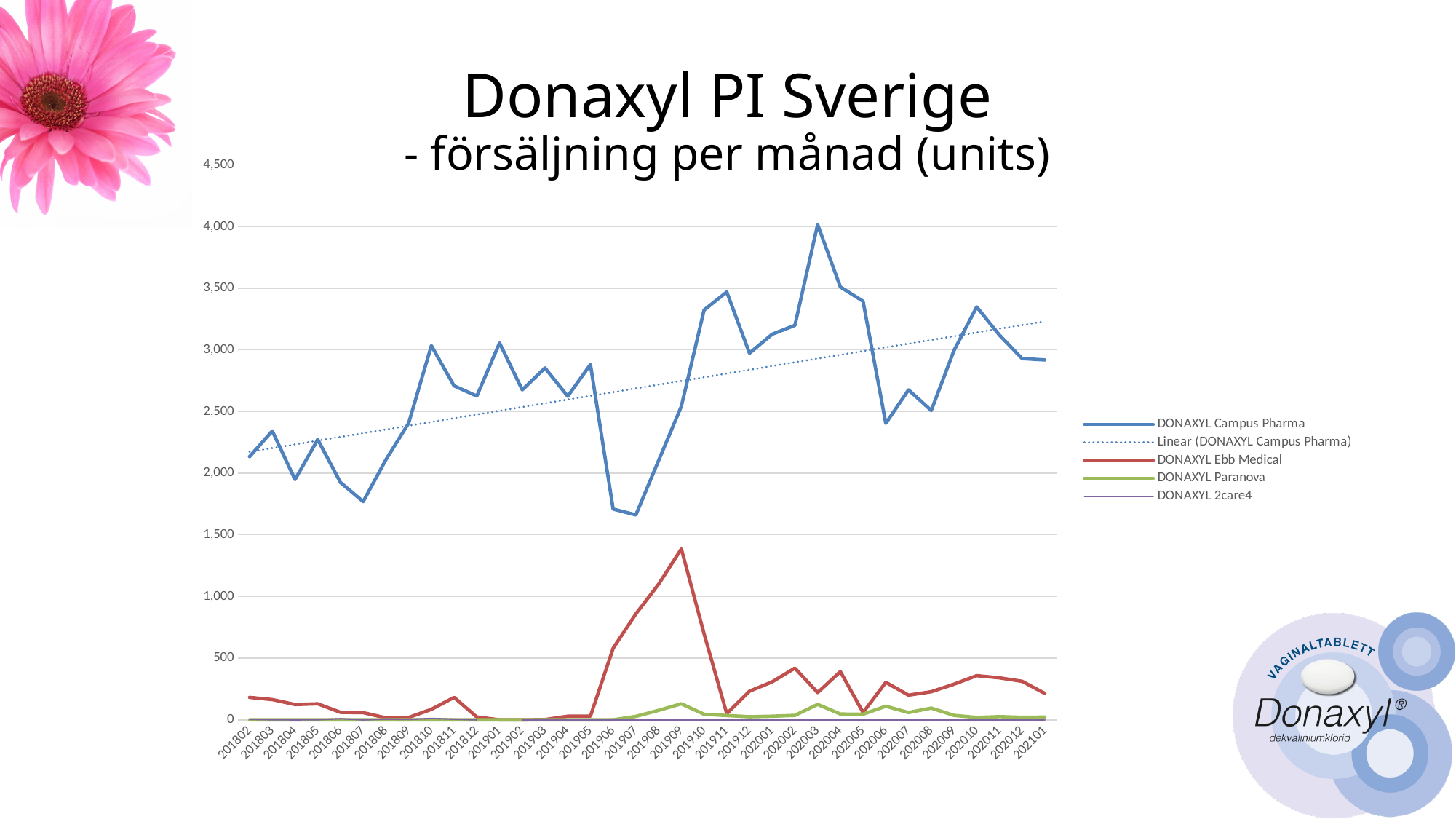
In which month does the DONAXYL Ebb Medical series reach its highest value? 201909 Is the value for DONAXYL Ebb Medical in 201909 greater or less than 1,000? greater How many entries does the legend list? 5 In 201909, which series has the larger value: DONAXYL Campus Pharma or DONAXYL Ebb Medical? DONAXYL Campus Pharma Is the value for DONAXYL Campus Pharma in 201907 greater or less than 2,000? less In which month does the DONAXYL Campus Pharma series reach its lowest value? 201907 How many months are plotted along the x axis? 36 Does the dotted linear trendline for DONAXYL Campus Pharma rise or fall from left to right? rise Is the value for DONAXYL Campus Pharma in 202003 greater or less than 3,500? greater What is the title of the chart? Donaxyl PI Sverige - försäljning per månad (units) In which month does the DONAXYL Campus Pharma series reach its highest value? 202003 What kind of chart is shown on the slide? line chart